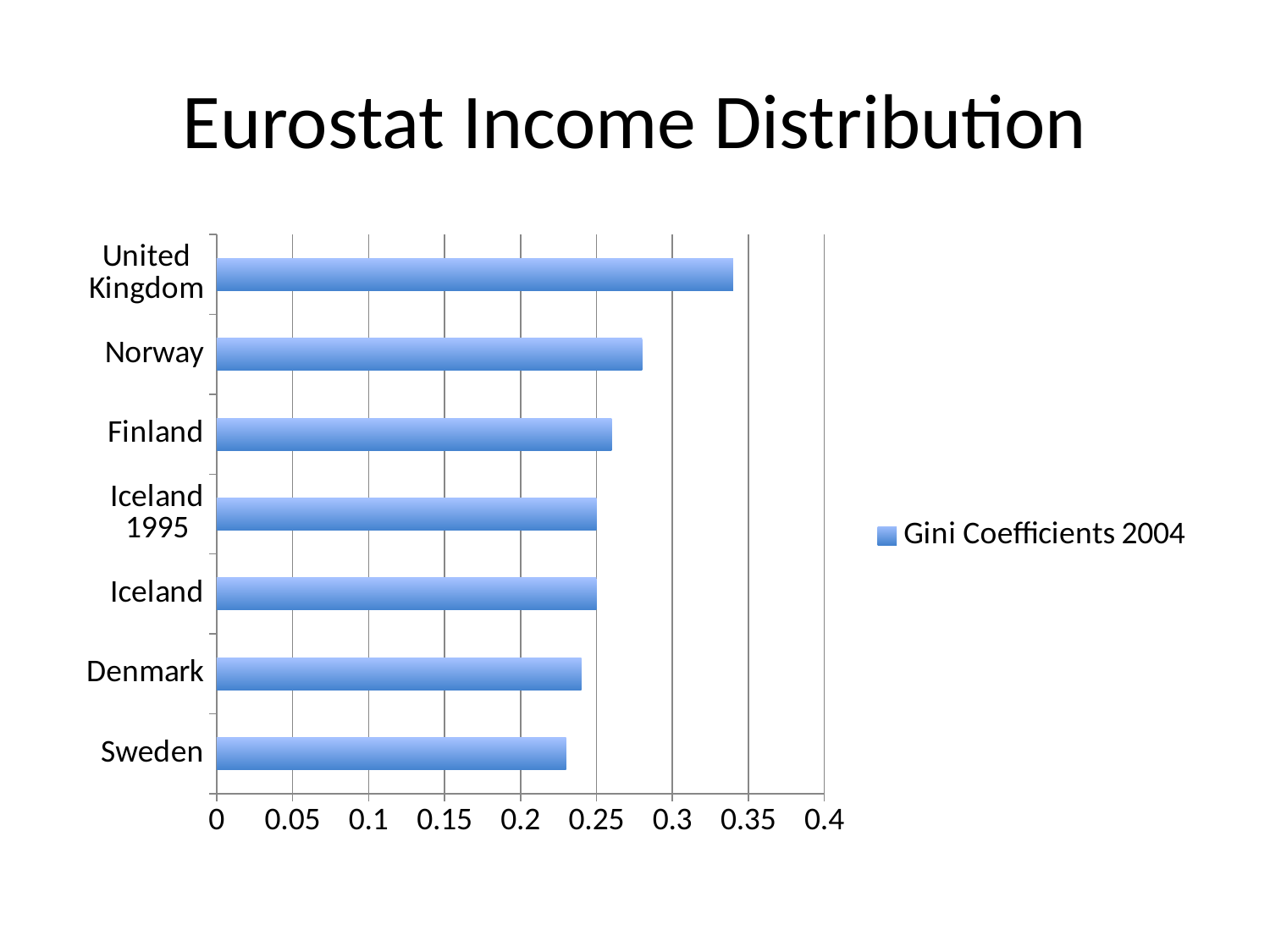
What is the Gini coefficient value for Iceland 1995? 0.25 What is the Gini coefficient value for Iceland? 0.25 Is the value for Sweden greater or less than 0.25? less Is the value for Norway greater or less than 0.3? less Which has the larger Gini coefficient, Norway or Finland? Norway What is the name of the series shown in the legend? Gini Coefficients 2004 Which country has the highest Gini coefficient in the chart? United Kingdom Is the value for United Kingdom greater or less than 0.3? greater How many series does the legend list? 1 What is the title of the slide? Eurostat Income Distribution How many countries (categories) are plotted in the chart? 7 What type of chart is shown on the slide? bar chart